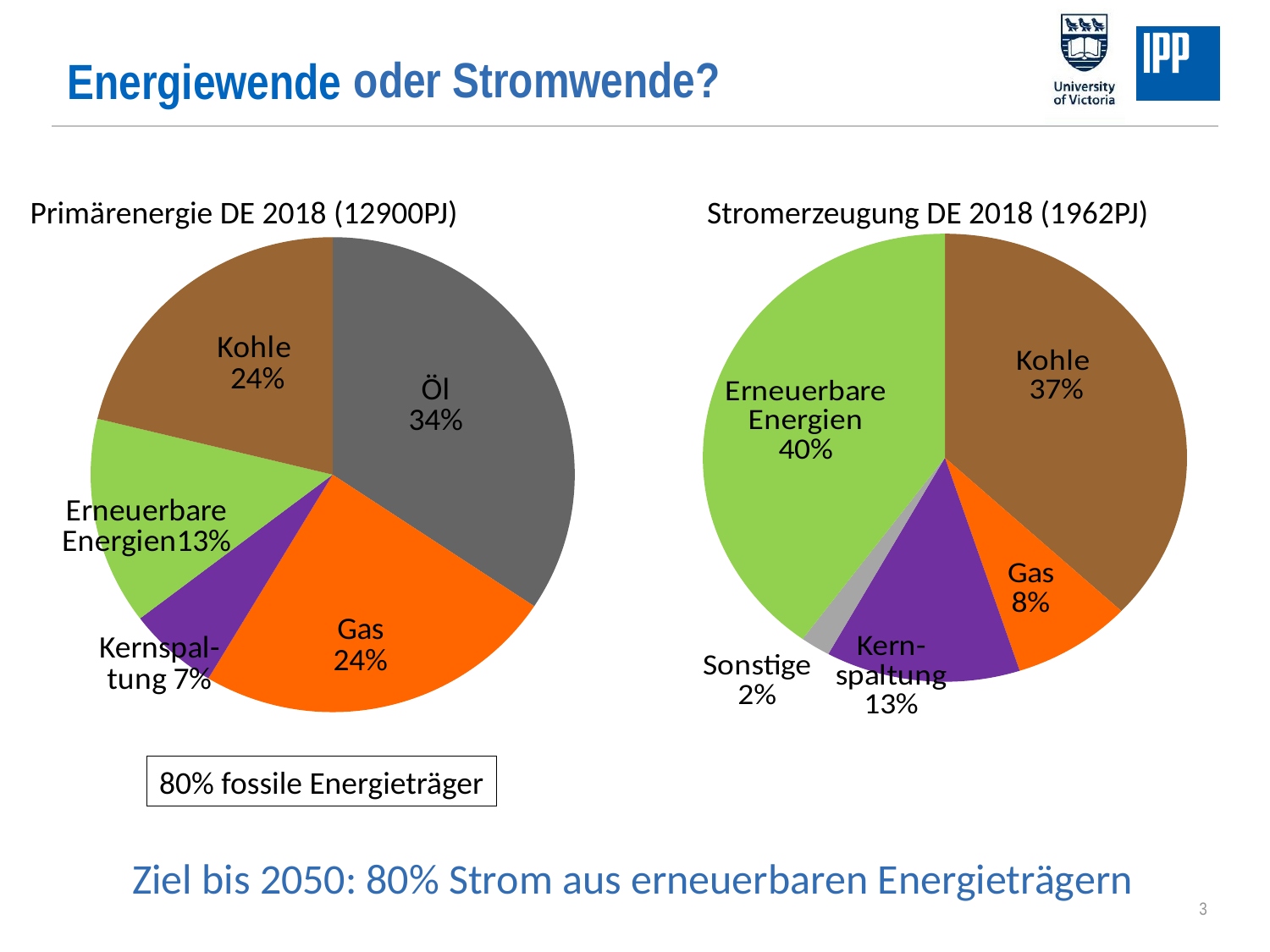
In the Primärenergie DE 2018 pie chart, what share does Öl have? 34% How many slices does the Primärenergie DE 2018 pie chart have? 5 In the Stromerzeugung DE 2018 pie chart, what share do Erneuerbare Energien have? 40% How many slices does the Stromerzeugung DE 2018 pie chart have? 5 In the Primärenergie DE 2018 pie chart, which category has the largest share? Öl In the Stromerzeugung DE 2018 pie chart, which category has the smallest share? Sonstige In the Stromerzeugung DE 2018 pie chart, what is the difference in percentage points between Kohle and Gas? 29 In the Stromerzeugung DE 2018 pie chart, what share does Kernspaltung have? 13% What total energy amount is given in the title of the Stromerzeugung DE 2018 chart? 1962PJ In the Primärenergie DE 2018 pie chart, which category has the smallest share? Kernspaltung What kind of chart is used for Primärenergie DE 2018? Pie chart In the Primärenergie DE 2018 pie chart, which is larger, the share of Kohle or the share of Erneuerbare Energien? Kohle